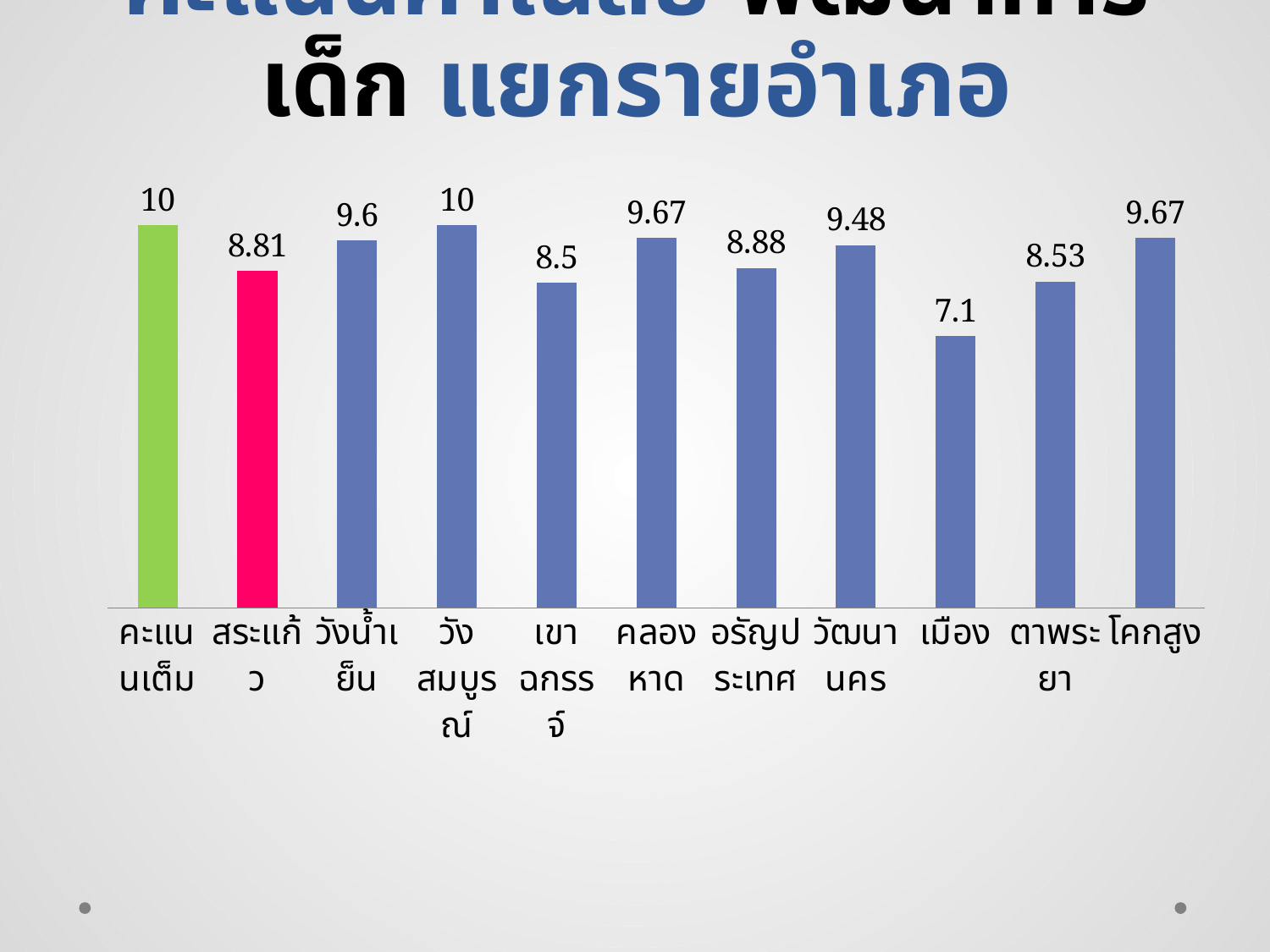
What colour is the bar for สระแก้ว? pink Which category has the lowest value? เมือง What is the value for ตาพระยา? 8.53 What kind of chart is shown on the slide? bar chart What is the difference between the values for วังน้ำเย็น and เขาฉกรรจ์? 1.1 What is the value for สระแก้ว? 8.81 What is the value for เมือง? 7.1 Which is larger, the value for เมือง or the value for ตาพระยา? ตาพระยา What is the difference between the values for คะแนนเต็ม and สระแก้ว? 1.19 How many bars are shown in the chart? 11 What is the value for วัฒนานคร? 9.48 Which is larger, the value for คลองหาด or the value for อรัญประเทศ? คลองหาด